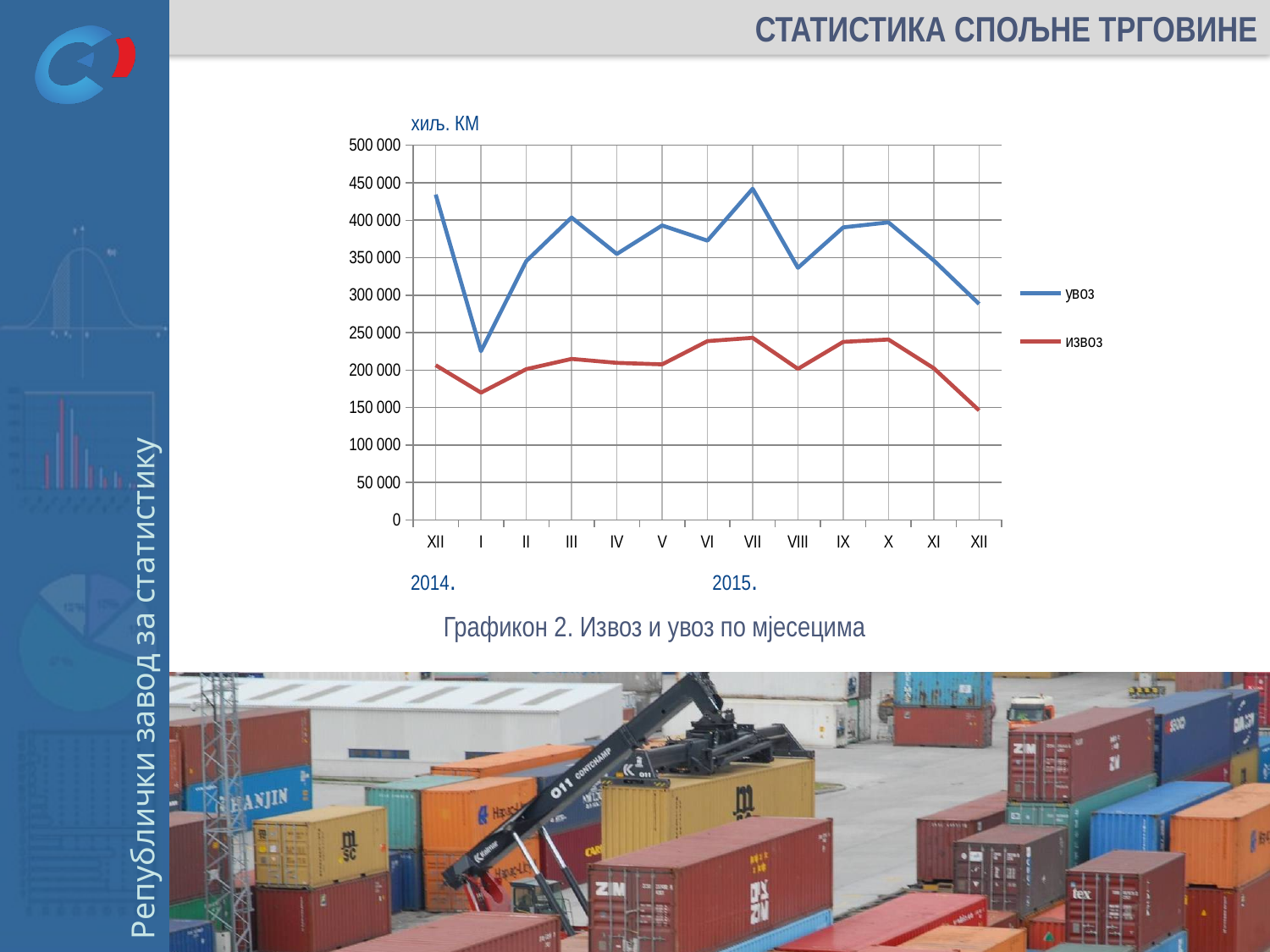
What kind of chart is shown on the slide? line chart Is the value for извоз in I 2015 greater or less than 200 000? less In which month is the value for увоз lowest? I (2015) Is the value for увоз in VII 2015 greater or less than 400 000? greater Is the value for увоз in I 2015 greater or less than 250 000? less How many months are plotted along the x axis? 13 Which is larger in VII 2015, увоз or извоз? увоз Does the value for извоз rise or fall from X 2015 to XII 2015? fall How many series does the legend list? 2 What unit is shown above the y axis of the chart? хиљ. КМ In which month is the value for извоз lowest? XII (2015)